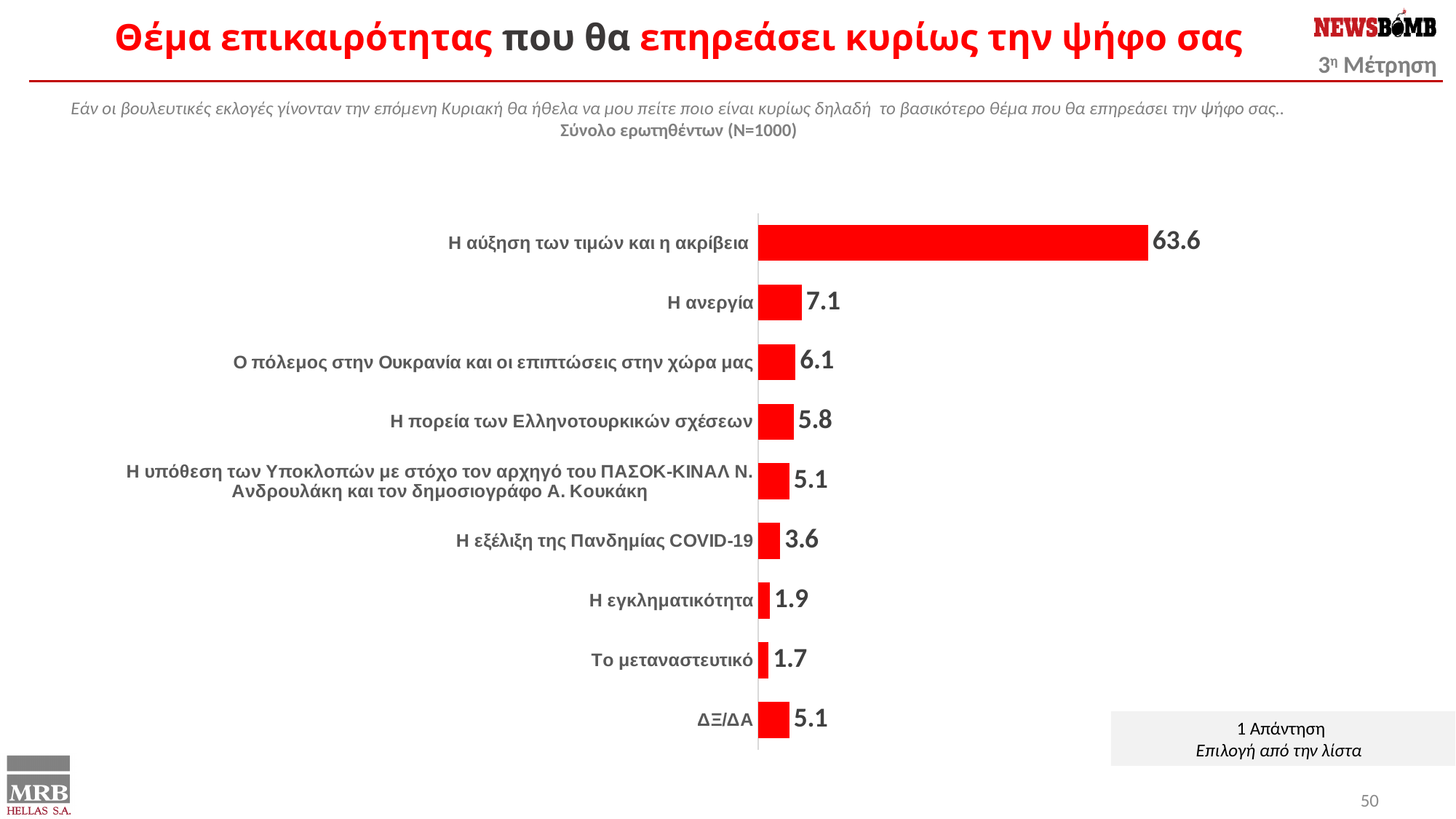
What is the value for "Η εξέλιξη της Πανδημίας COVID-19"? 3.6 What is the difference between the values for "Η αύξηση των τιμών και η ακρίβεια" and "Η ανεργία"? 56.5 What kind of chart is shown on the slide? Bar chart What is the value for "Η ανεργία"? 7.1 What is the value for "Το μεταναστευτικό"? 1.7 Which category has the lowest value? Το μεταναστευτικό What is the value for "Η αύξηση των τιμών και η ακρίβεια"? 63.6 Which category has the highest value? Η αύξηση των τιμών και η ακρίβεια Which is larger, the value for "Η πορεία των Ελληνοτουρκικών σχέσεων" or the value for "Η εγκληματικότητα"? Η πορεία των Ελληνοτουρκικών σχέσεων What is the difference between the values for "Η ανεργία" and "Ο πόλεμος στην Ουκρανία και οι επιπτώσεις στην χώρα μας"? 1.0 What colour are the bars in the chart? Red How many categories are shown in the chart? 9